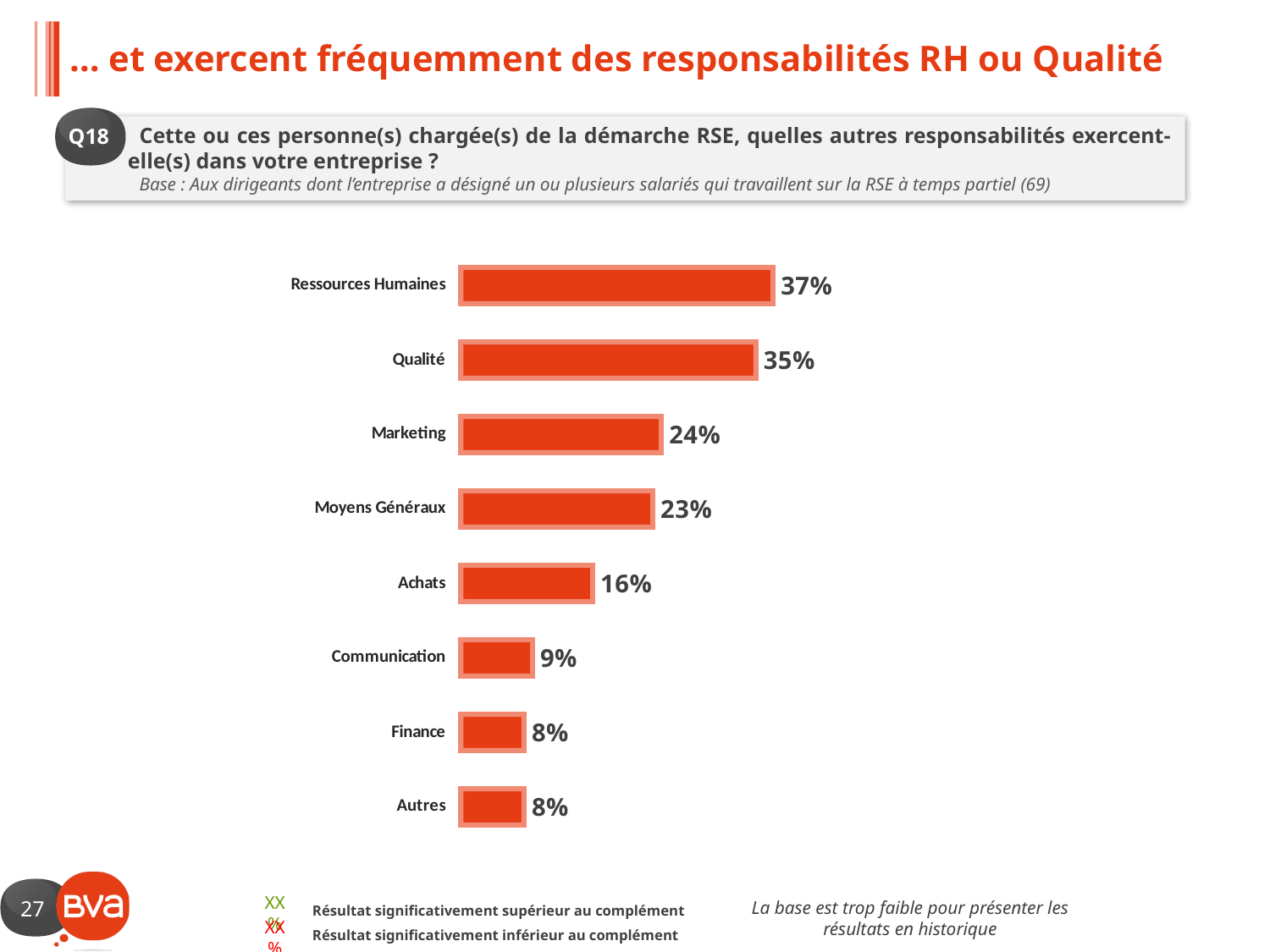
What is the value for Communication? 9% What is the value for Achats? 16% Which is larger, the value for Marketing or the value for Achats? Marketing What is the value for Ressources Humaines? 37% Which categories share the lowest value of 8%? Finance and Autres How many categories are shown in the chart? 8 What is the difference between the values for Qualité and Moyens Généraux? 12% What kind of chart is shown on the slide? Bar chart What is the difference between the values for Ressources Humaines and Qualité? 2% What colour are the bars in the chart? Orange-red What is the value for Marketing? 24% Which category has the highest value? Ressources Humaines